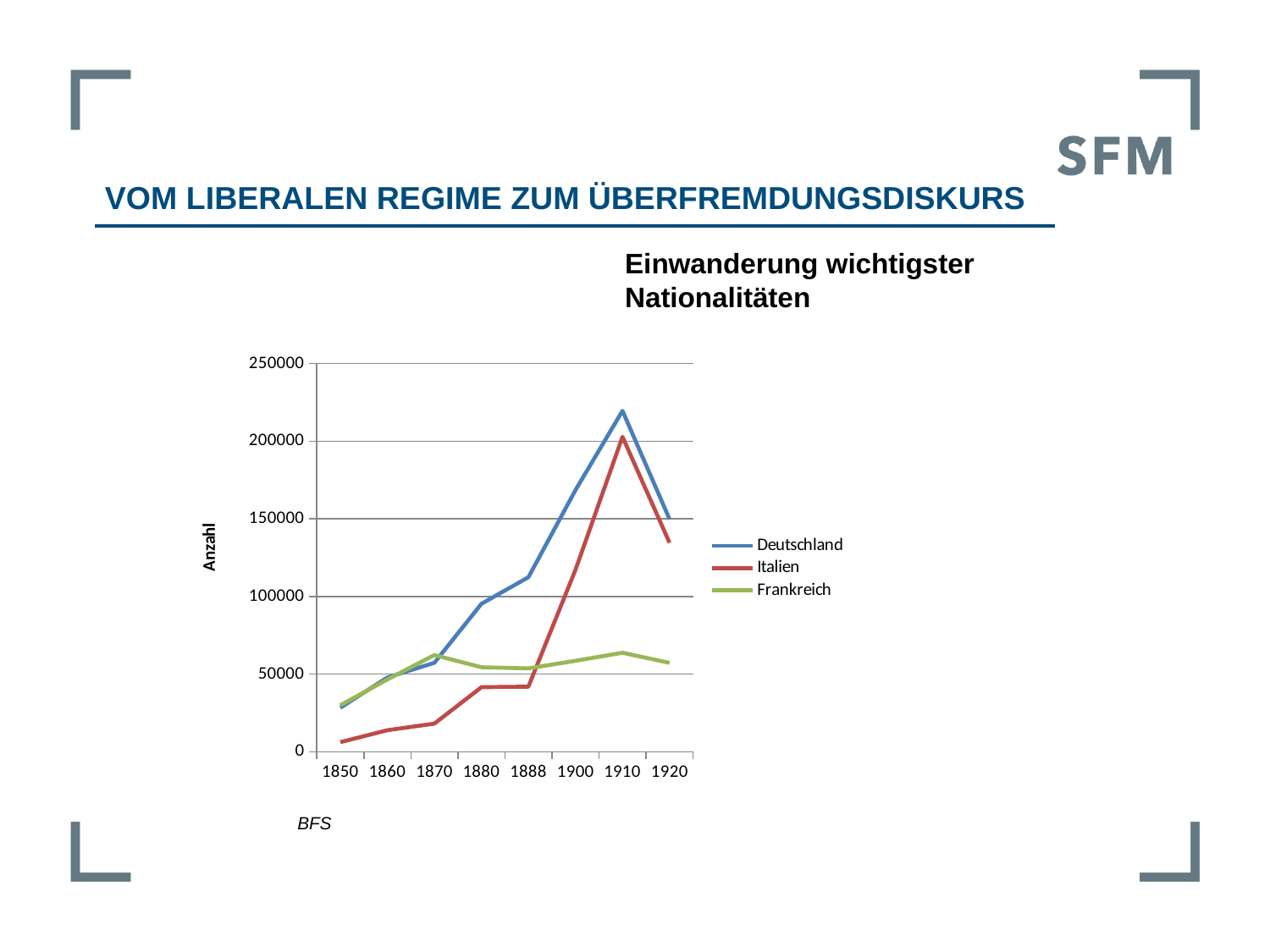
How many years are marked on the x axis? 8 Which series reaches the highest value on the chart? Deutschland Which series has the lowest value in 1850? Italien Which is larger in 1900, the value for Deutschland or the value for Frankreich? Deutschland What kind of chart is shown on the slide? line chart Does the Italien line rise or fall between 1888 and 1910? rise In which year does the Deutschland line reach its peak? 1910 How many series does the legend list? 3 What is the label on the y axis? Anzahl Is the value for Deutschland in 1910 greater or less than 200000? greater Is the value for Frankreich in 1910 greater or less than 100000? less Is the value for Italien in 1850 greater or less than 50000? less